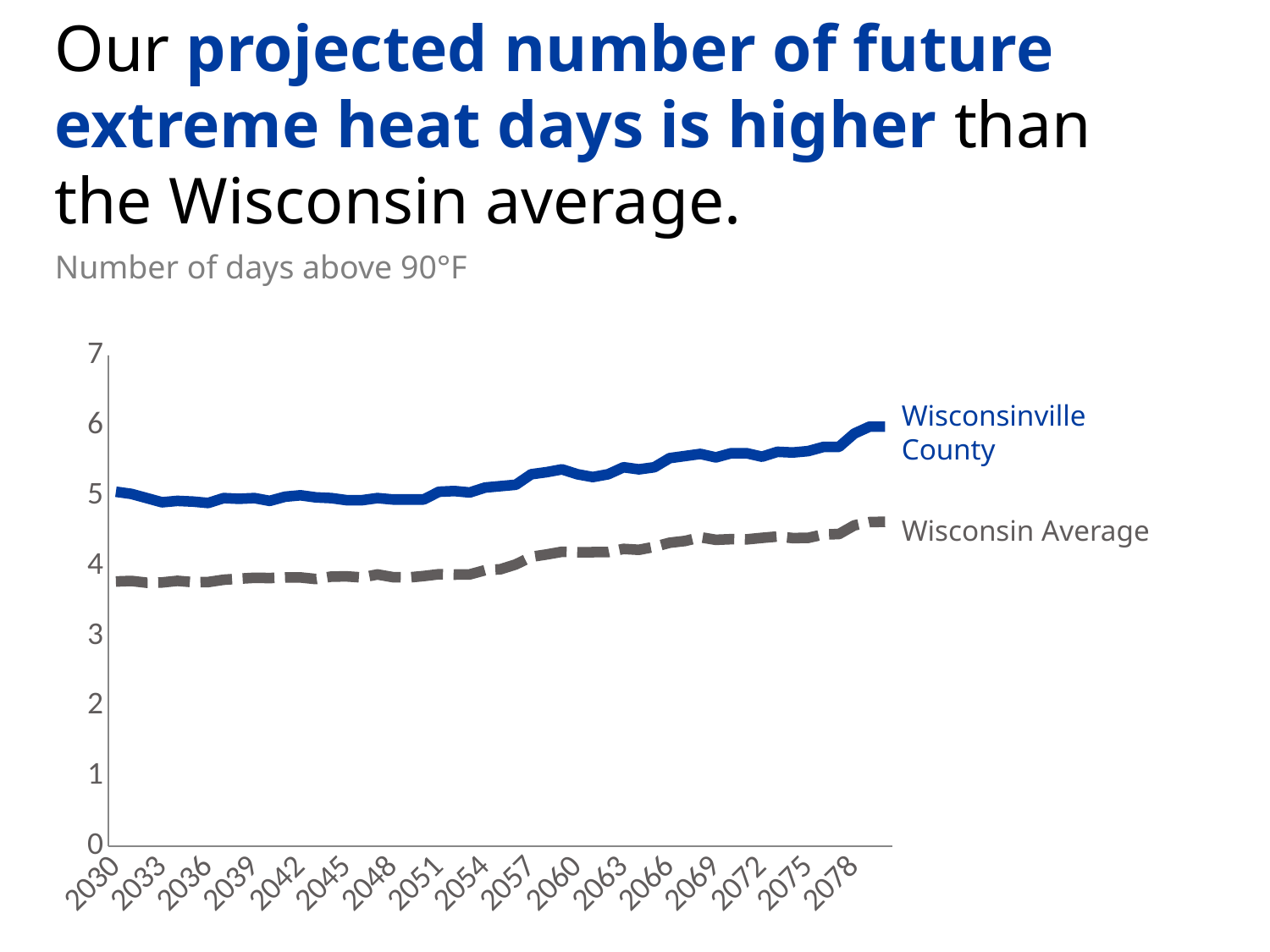
Does the Wisconsin Average line generally rise or fall from 2030 to 2078? Rise How many year labels are shown on the x axis? 17 Which series has the lower value in 2030? Wisconsin Average Is the value for Wisconsin Average in 2030 greater or less than 4? less What kind of chart is shown on the slide? Line chart Is the value for Wisconsin Average in 2078 greater or less than 5? less Is the value for Wisconsinville County in 2060 greater or less than 5? greater How many series are plotted on the chart? 2 Which series is plotted with a dashed line? Wisconsin Average What does the y axis measure, according to the subtitle above the chart? Number of days above 90°F Does the Wisconsinville County line generally rise or fall from 2030 to 2078? Rise Which series has the higher value in 2060? Wisconsinville County